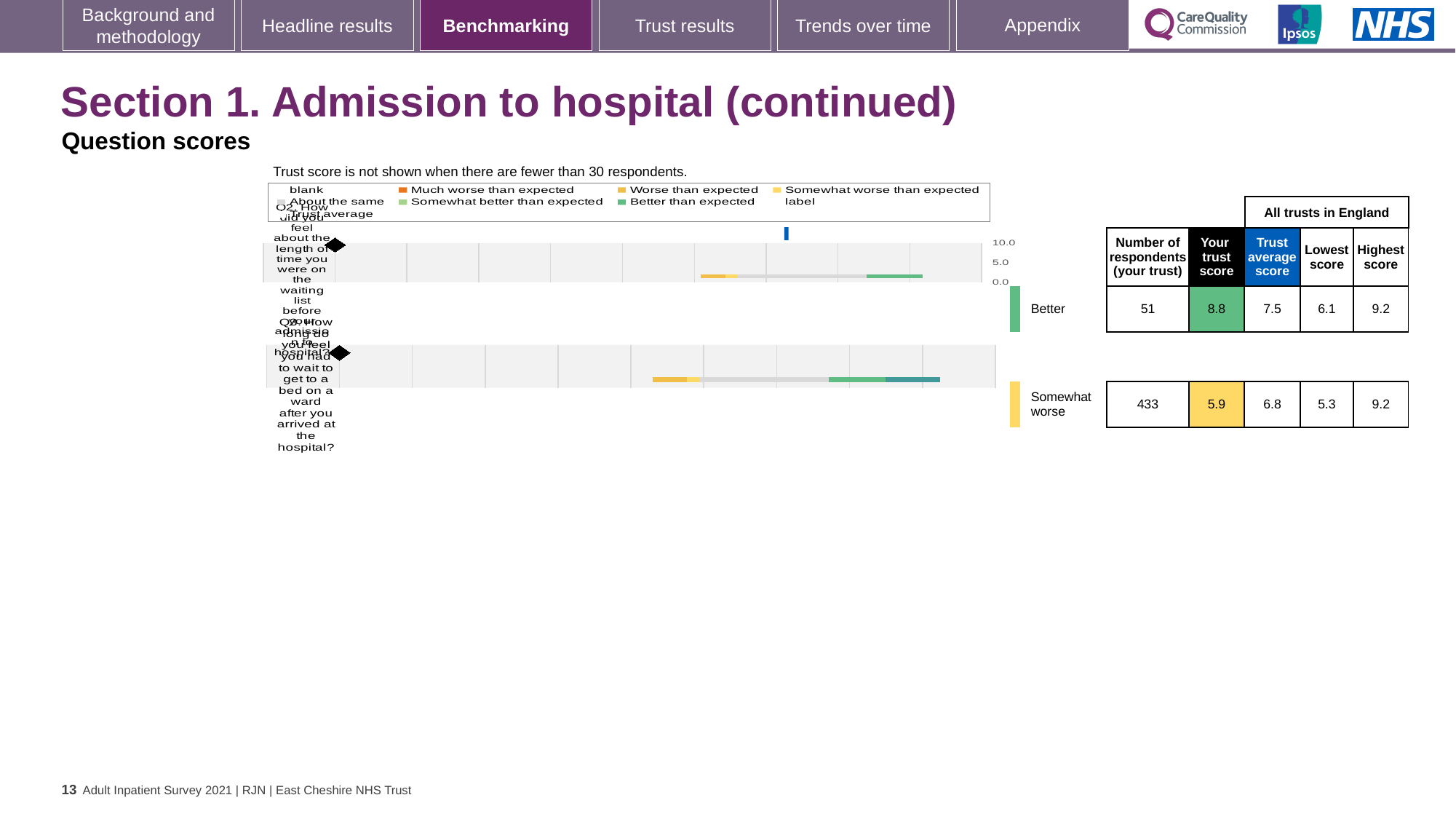
Which question has the higher trust score, Q2 or Q3? Q2 How many questions are plotted in the question scores chart? 2 What is the trust score for Q2 (length of time on the waiting list before admission)? 8.8 What is the trust average score for Q2? 7.5 What is the trust score for Q3 (wait to get to a bed on a ward after arriving at the hospital)? 5.9 What benchmark category is shown for Q3? Somewhat worse What is the lowest score across all trusts in England for Q3? 5.3 By how much does the trust score for Q2 exceed the trust average score? 1.3 By how much is the trust score for Q3 below the trust average score? 0.9 What kind of chart is used to show the question scores on this slide? bar chart For Q2, which is larger: the trust's own score or the trust average score? Your trust score How many respondents answered Q3 for this trust? 433